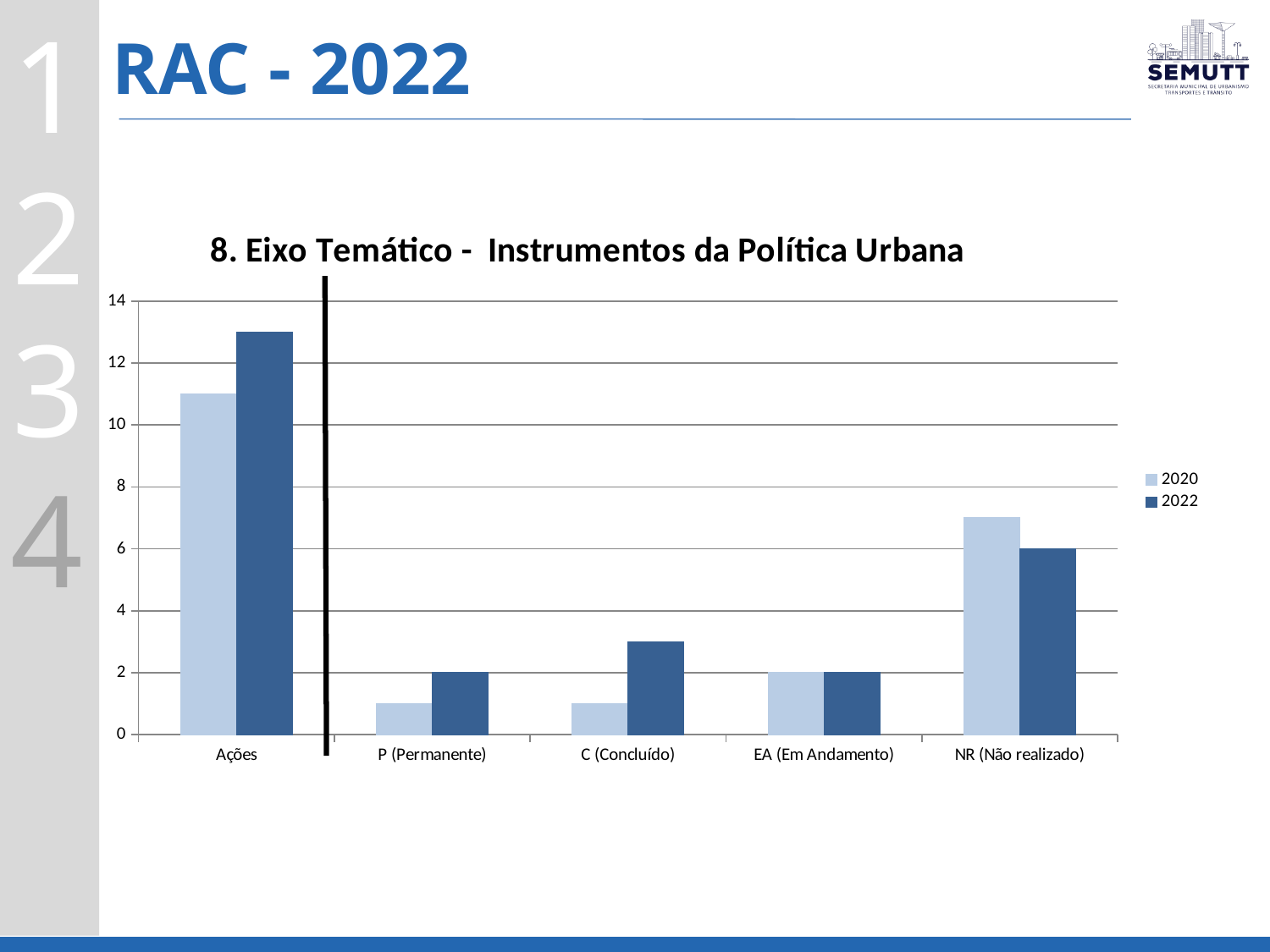
For NR (Não realizado), which year has the larger value, 2020 or 2022? 2020 What is the value for NR (Não realizado) in 2022? 6 How many categories are shown on the x axis? 5 How many series does the legend list? 2 Is the 2020 value for Ações greater or less than 10? greater What is the value for EA (Em Andamento) in 2020? 2 What is the title of the chart? 8. Eixo Temático - Instrumentos da Política Urbana For Ações, which year has the larger value, 2020 or 2022? 2022 What is the value for P (Permanente) in 2022? 2 Is the 2022 value for Ações greater or less than 12? greater What kind of chart is shown on the slide? bar chart Which category has the highest value for the 2022 series? Ações